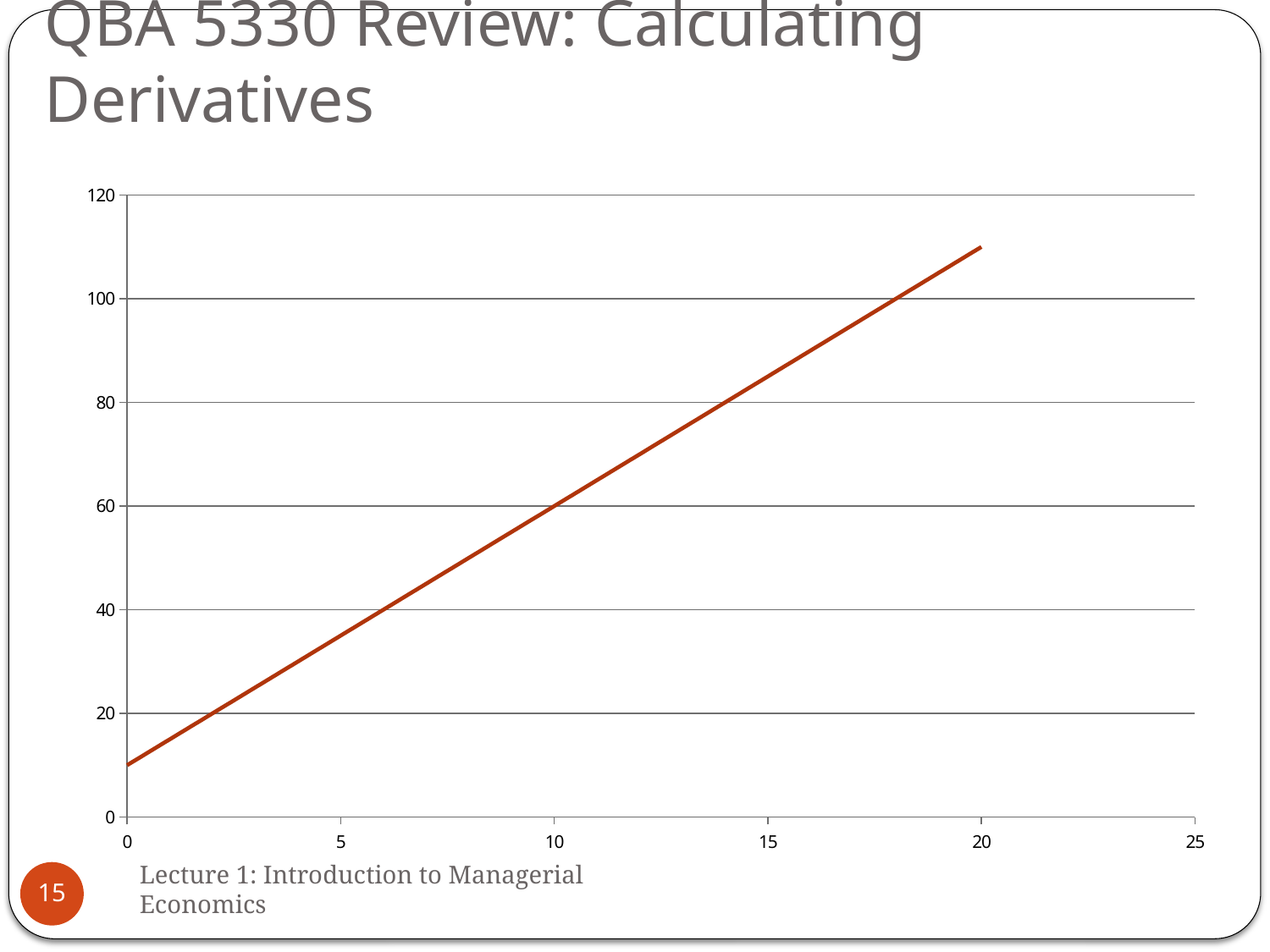
Is the value of the line at x = 15 greater or less than 80? greater What kind of chart is shown on the slide? line chart Is the value of the line at x = 20 greater or less than 100? greater What is the highest value shown on the vertical axis? 120 What is the highest value shown on the horizontal axis? 25 Is the value of the line at x = 15 greater or less than 100? less Do the values on the line rise or fall as x increases from 0 to 20? rise What is the value of the line at x = 10? 60 Which is larger, the value of the line at x = 5 or at x = 15? x = 15